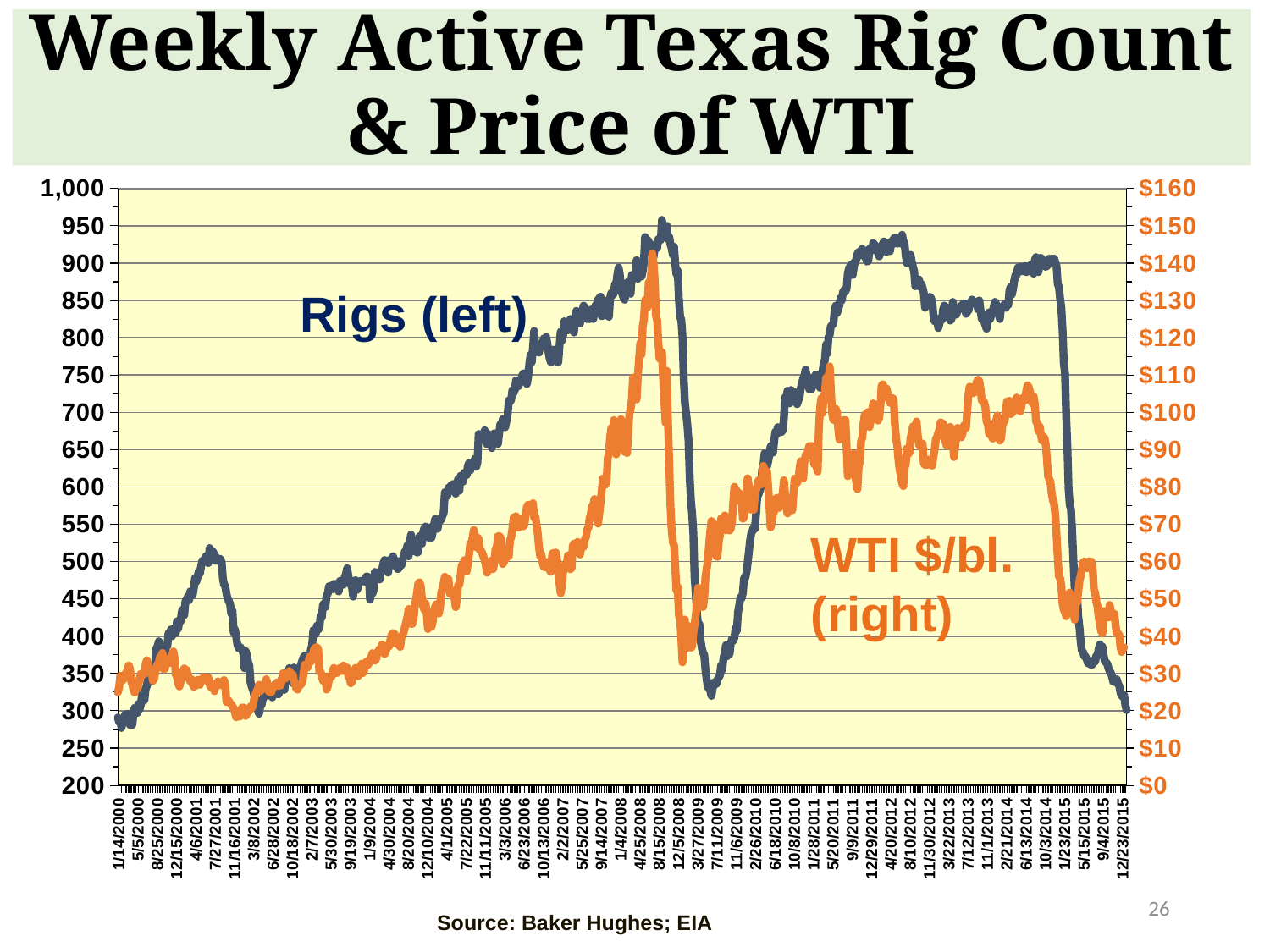
Does the Texas rig count rise or fall between late 2014 and the end of 2015? fall What is the highest value shown on the right-hand (WTI) axis? $160 Is the Texas rig count at the start of the series (1/14/2000) greater or less than 350? less Does the Texas rig count rise or fall between 2003 and mid-2008? rise Is the peak Texas rig count reached in 2008 greater or less than 900? greater Is the Texas rig count at its 2009 low point greater or less than 400? less What is the title of the chart? Weekly Active Texas Rig Count & Price of WTI How many data series are plotted on the chart? 2 What kind of chart is shown on the slide? line chart